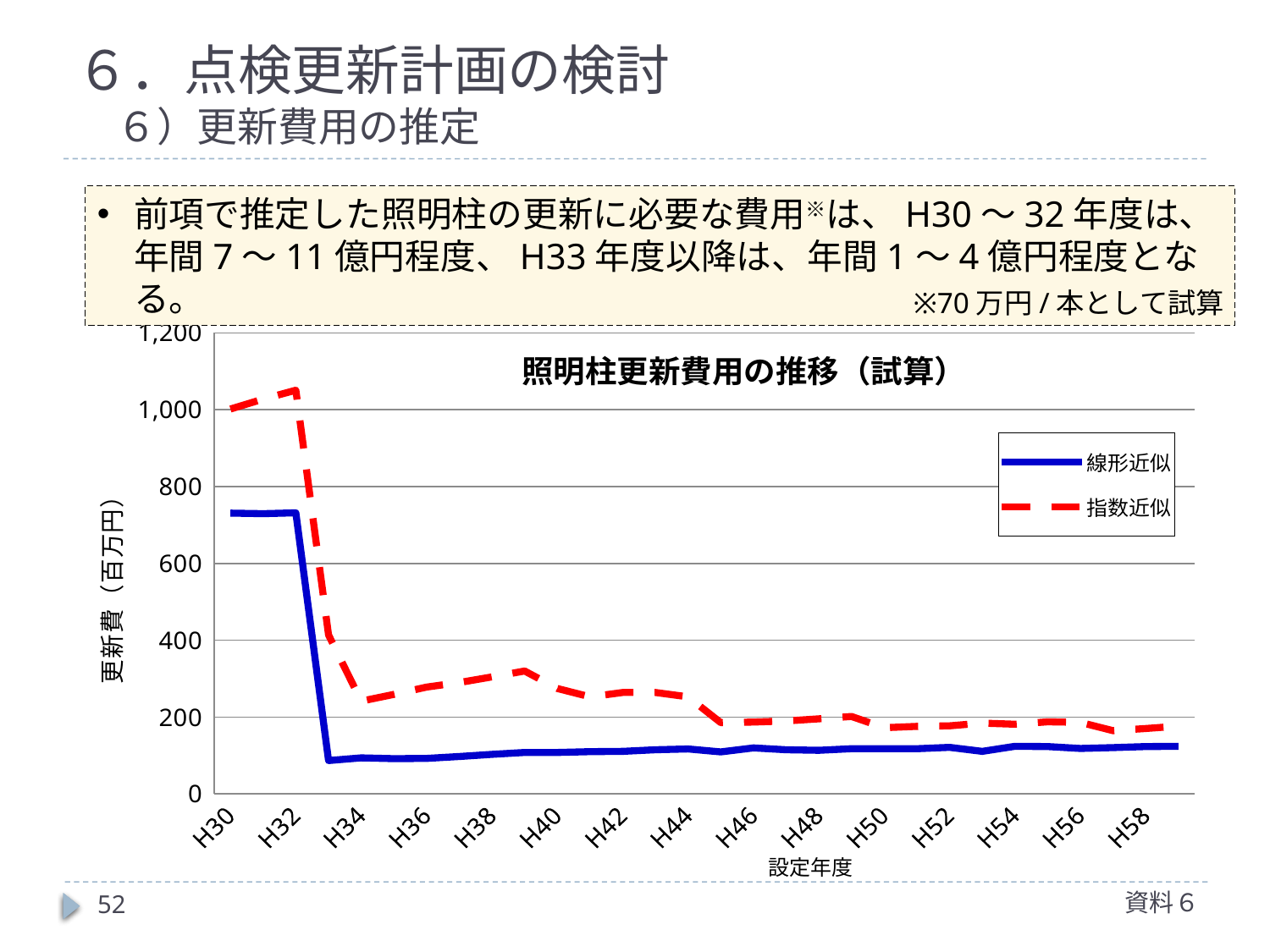
How many year labels are shown on the x axis? 15 How many series does the legend list? 2 Does the 線形近似 line rise or fall between H32 and H34? fall Is the value for 指数近似 at H50 greater or less than 400? less At H30, which series has the higher value, 線形近似 or 指数近似? 指数近似 Is the value for 線形近似 at H34 greater or less than 200? less Is the value for 指数近似 at H40 greater or less than 200? greater What kind of chart is shown on the slide? line chart What is the title of the chart? 照明柱更新費用の推移（試算） What is the label of the y axis? 更新費（百万円）